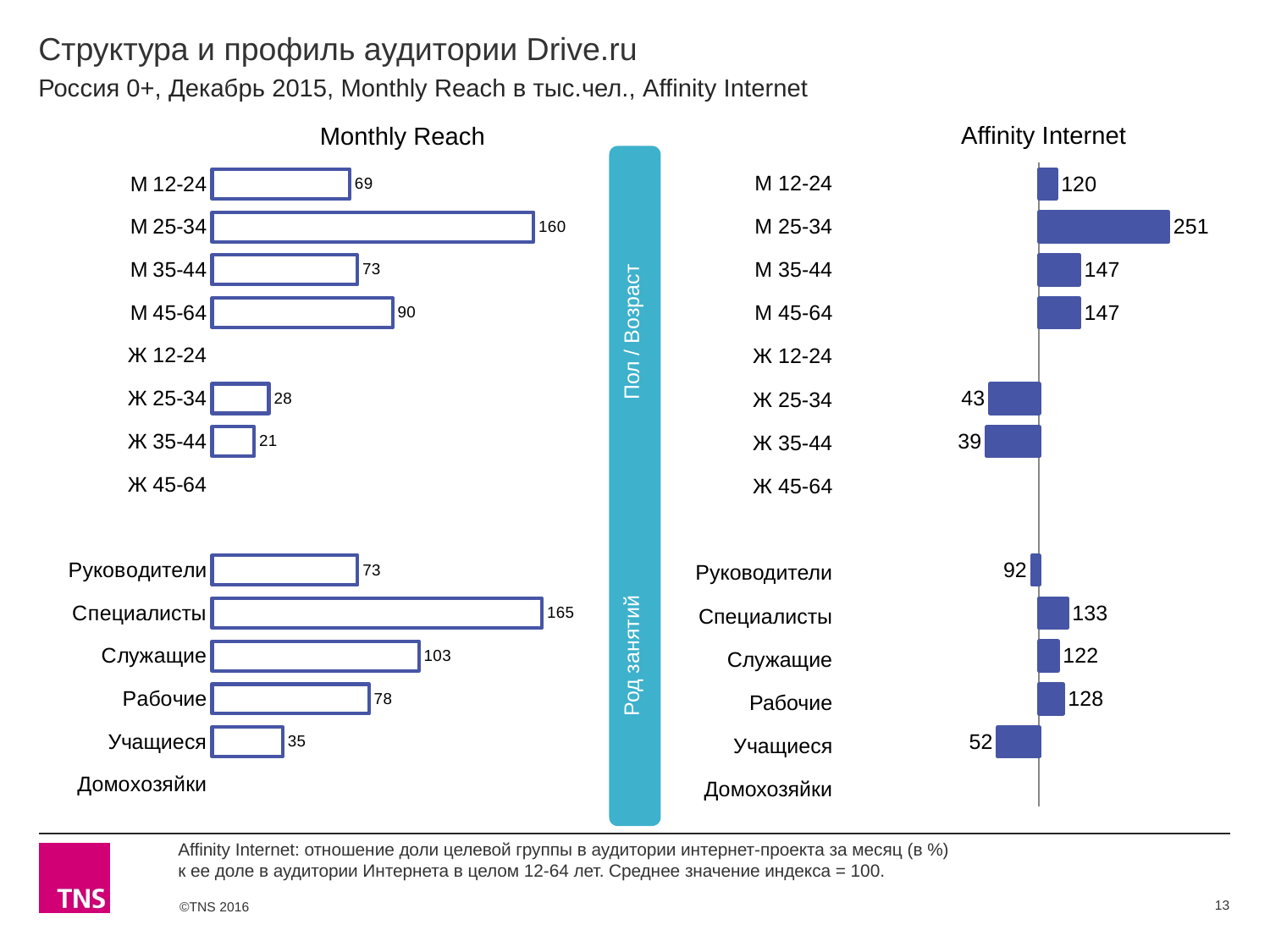
What type of chart is the Monthly Reach chart? Bar chart In the Affinity Internet chart, what is the value for Учащиеся? 52 In the Monthly Reach chart, which is larger, М 45-64 or М 35-44? М 45-64 In the Monthly Reach chart, what is the difference between Служащие and Рабочие? 25 In the Affinity Internet chart, which is larger, Рабочие or Руководители? Рабочие In the Monthly Reach chart, which labelled category has the lowest value? Ж 35-44 In the Affinity Internet chart, what is the difference between М 25-34 and М 12-24? 131 In the Monthly Reach chart, which category has the highest value? Специалисты In the Affinity Internet chart, what is the value for Ж 35-44? 39 In the Monthly Reach chart, what is the value for М 25-34? 160 In the Affinity Internet chart, which category has the highest value? М 25-34 In the Affinity Internet chart, what is the value for Специалисты? 133